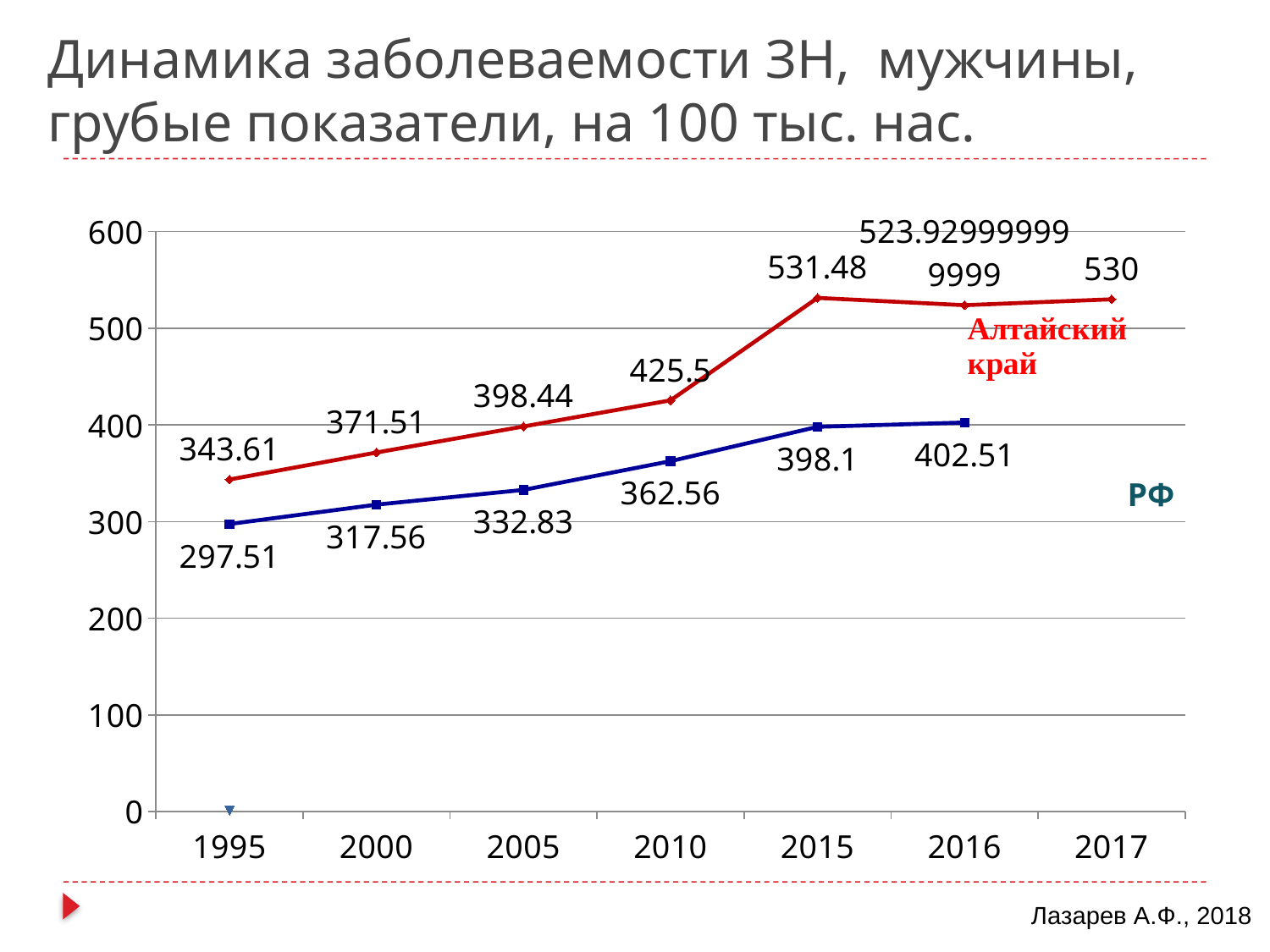
What is the value for РФ in 2016? 402.51 What is the value for Алтайский край in 2017? 530 In which year is the value for Алтайский край highest? 2015 What is the value for Алтайский край in 2015? 531.48 In which year is the value for РФ lowest? 1995 Which is larger in 2005: the value for Алтайский край or for РФ? Алтайский край What is the value for РФ in 2010? 362.56 What is the value for Алтайский край in 1995? 343.61 What is the difference between the Алтайский край and РФ values in 2015? 133.38 How many years are shown on the x axis? 7 Is the value for Алтайский край in 2016 greater or less than 500? greater What type of chart is shown on the slide? line chart